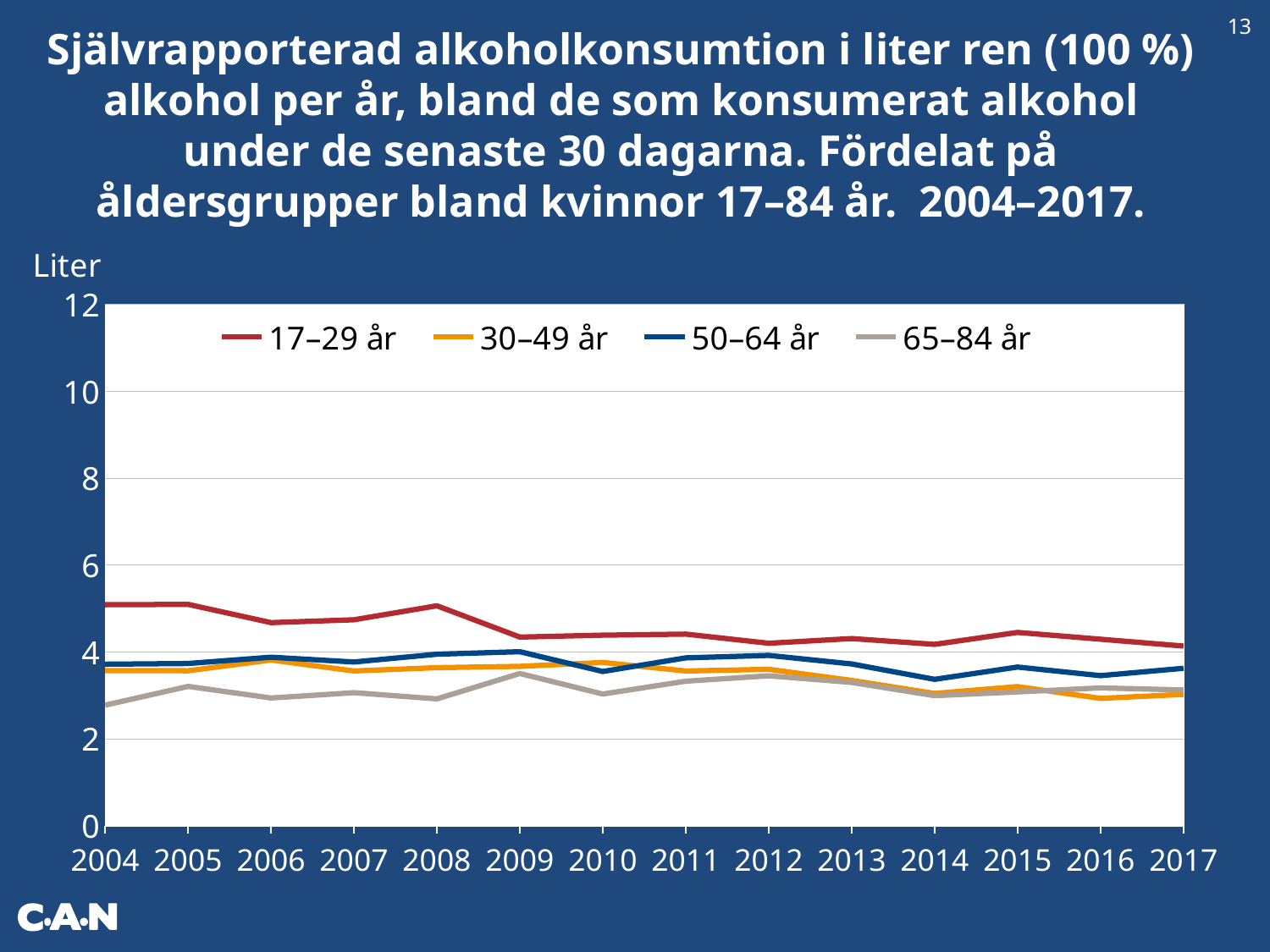
Which age group has the lowest value in 2004? 65–84 år Is the value for 30–49 år in 2016 greater or less than 4? less Which age group has the highest value in 2004? 17–29 år What is the label on the y axis? Liter In 2004, which is larger: the value for 17–29 år or the value for 65–84 år? 17–29 år How many years are shown along the x axis? 14 In 2017, which is larger: the value for 50–64 år or the value for 30–49 år? 50–64 år Is the value for 17–29 år in 2004 greater or less than 4? greater How many series does the legend list? 4 Does the value for 17–29 år rise or fall from 2004 to 2017? fall Is the value for 65–84 år in 2004 greater or less than 3? less What kind of chart is shown on the slide? line chart